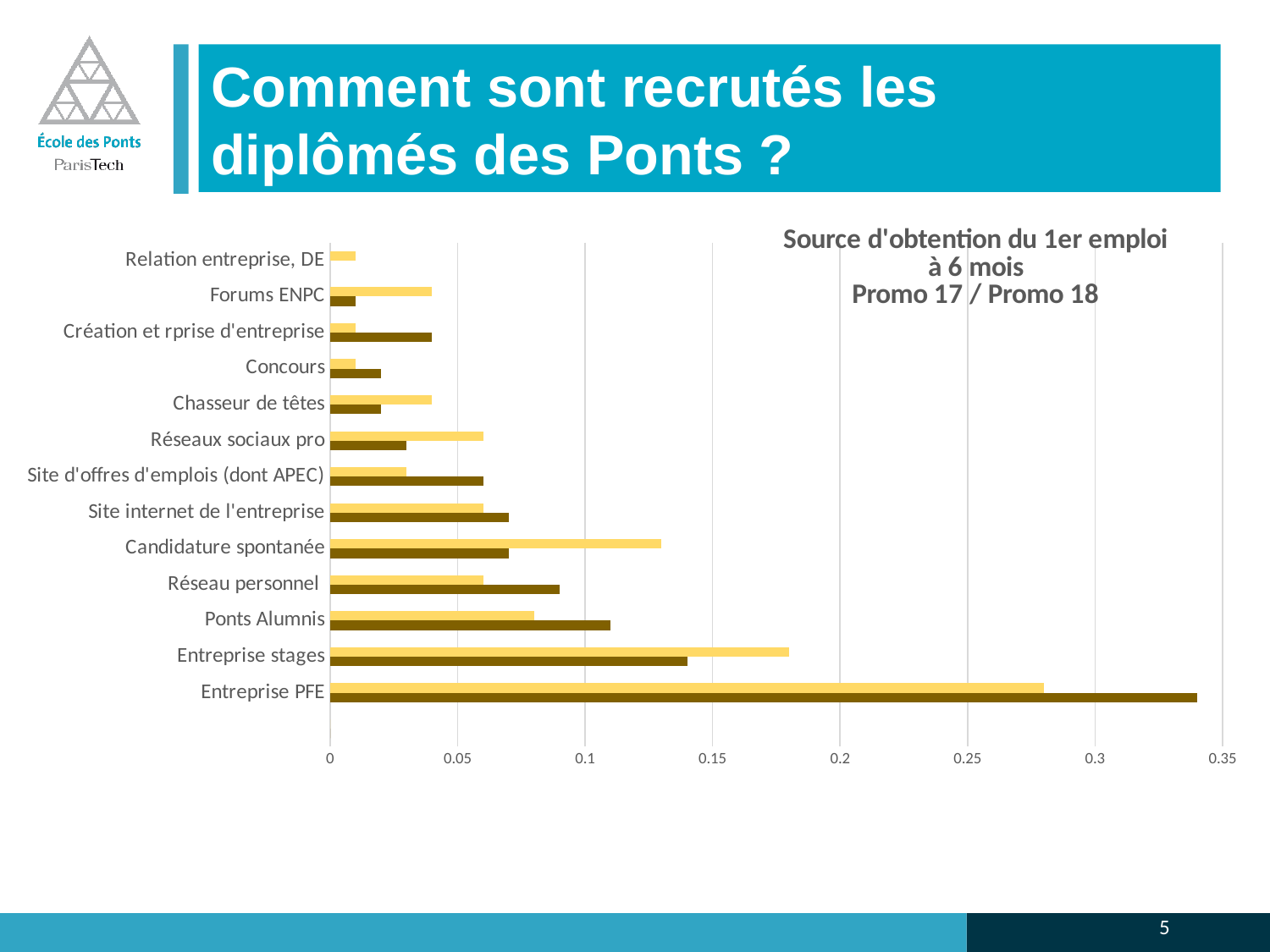
How many categories are listed on the vertical axis of the chart? 13 For Candidature spontanée, which bar is longer: the light yellow bar or the dark gold bar? the light yellow bar Is the dark gold bar for Réseau personnel greater or less than 0.05? greater What is the title of the chart? Source d'obtention du 1er emploi à 6 mois Promo 17 / Promo 18 For Ponts Alumnis, which bar is longer: the light yellow bar or the dark gold bar? the dark gold bar Which category has the shortest bars in the chart? Relation entreprise, DE Is the dark gold bar for Entreprise PFE greater or less than 0.3? greater What kind of chart is shown on the slide? bar chart Is the light yellow bar for Candidature spontanée greater or less than 0.1? greater Which has the longer dark gold bar: Entreprise PFE or Entreprise stages? Entreprise PFE Which category has the longest bar in the chart? Entreprise PFE